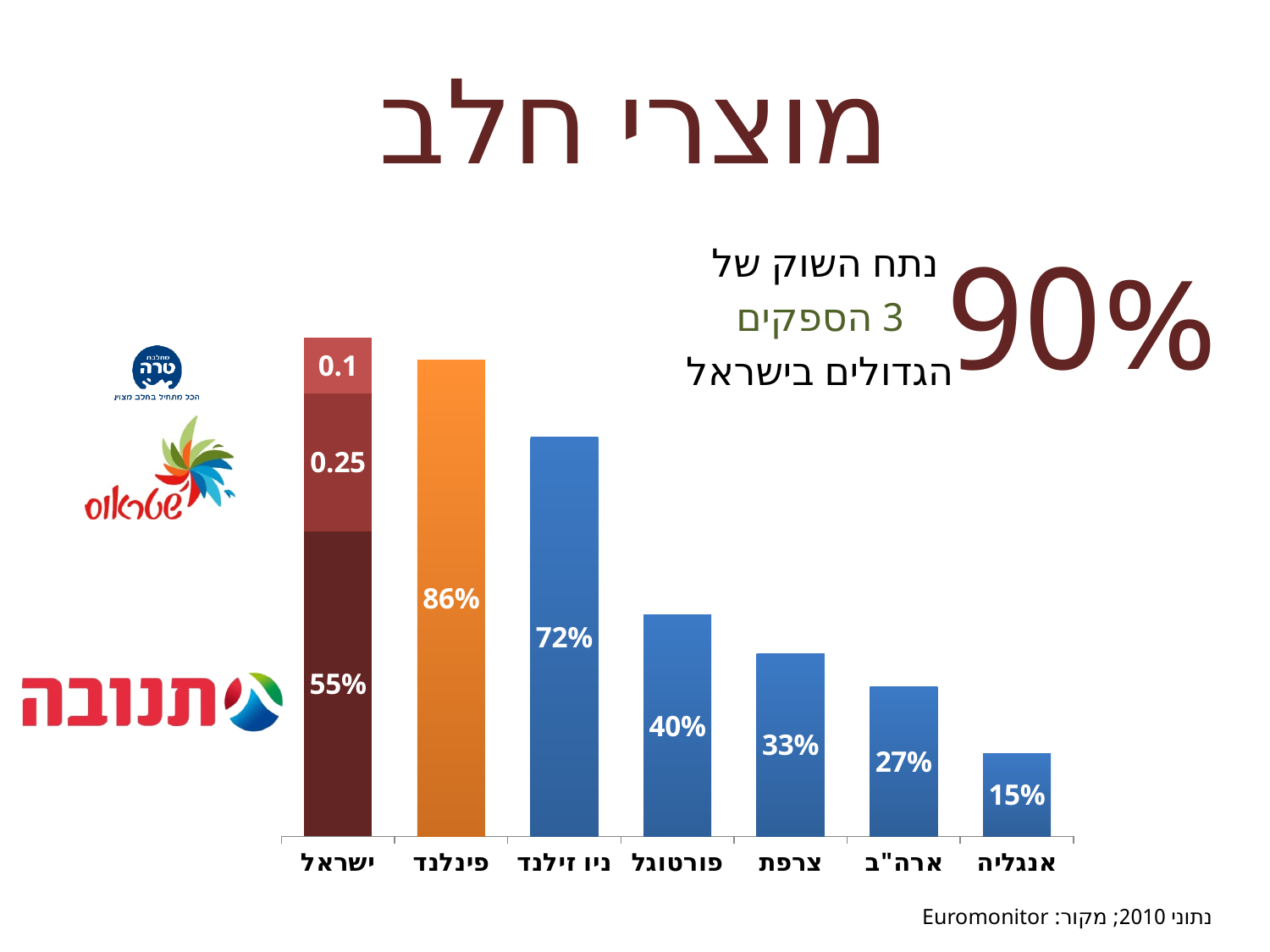
What is the difference between the values for פינלנד (Finland) and ניו זילנד (New Zealand)? 14% Do the values of the single-segment bars rise or fall from פינלנד (Finland) to אנגליה (England) along the x axis? fall What is the value of the bottom (largest) segment of the ישראל (Israel) bar? 55% Which country has the lowest value in the chart? אנגליה What is the difference between the values for ארה"ב (USA) and אנגליה (England)? 12% Which is larger, the value for פורטוגל (Portugal) or the value for צרפת (France)? פורטוגל What is the value shown for ניו זילנד (New Zealand)? 72% What kind of chart is shown on the slide? bar chart How many countries are shown on the x axis of the chart? 7 What is the value of the top segment of the ישראל (Israel) bar? 0.1 What is the value shown for פינלנד (Finland)? 86% What is the value shown for אנגליה (England)? 15%